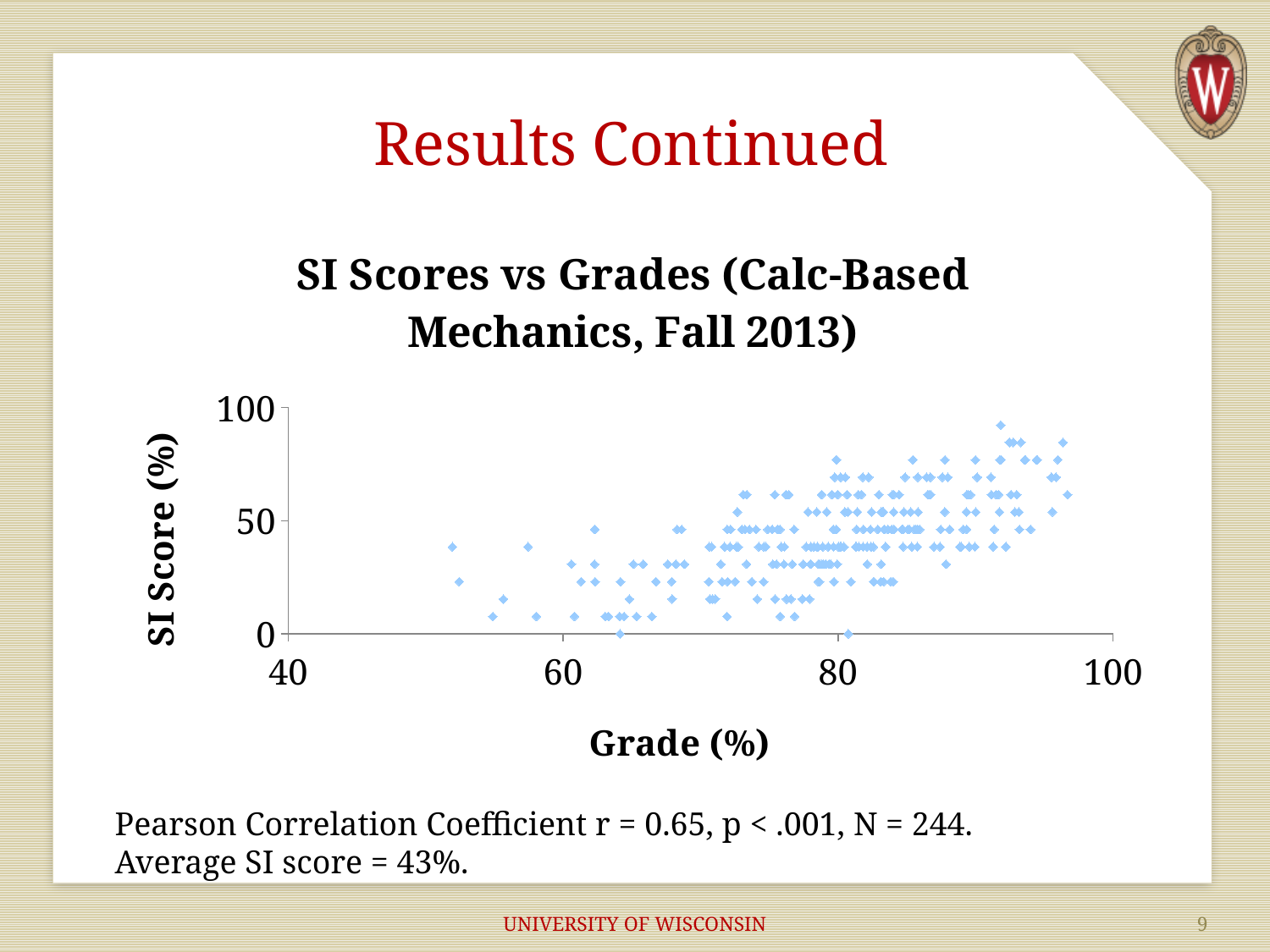
Is the lowest grade plotted greater or less than 60? less What kind of chart is shown on the slide? scatter plot How many data points (N) are plotted in the chart, according to the slide? 244 What is the lowest tick value shown on the x axis? 40 What is the label of the x axis? Grade (%) Is the highest SI score plotted greater or less than 50? greater Do SI scores generally rise or fall as grade increases along the x axis? rise What is the title of the chart? SI Scores vs Grades (Calc-Based Mechanics, Fall 2013) What is the highest tick value shown on the y axis? 100 Is the highest grade plotted greater or less than 100? less